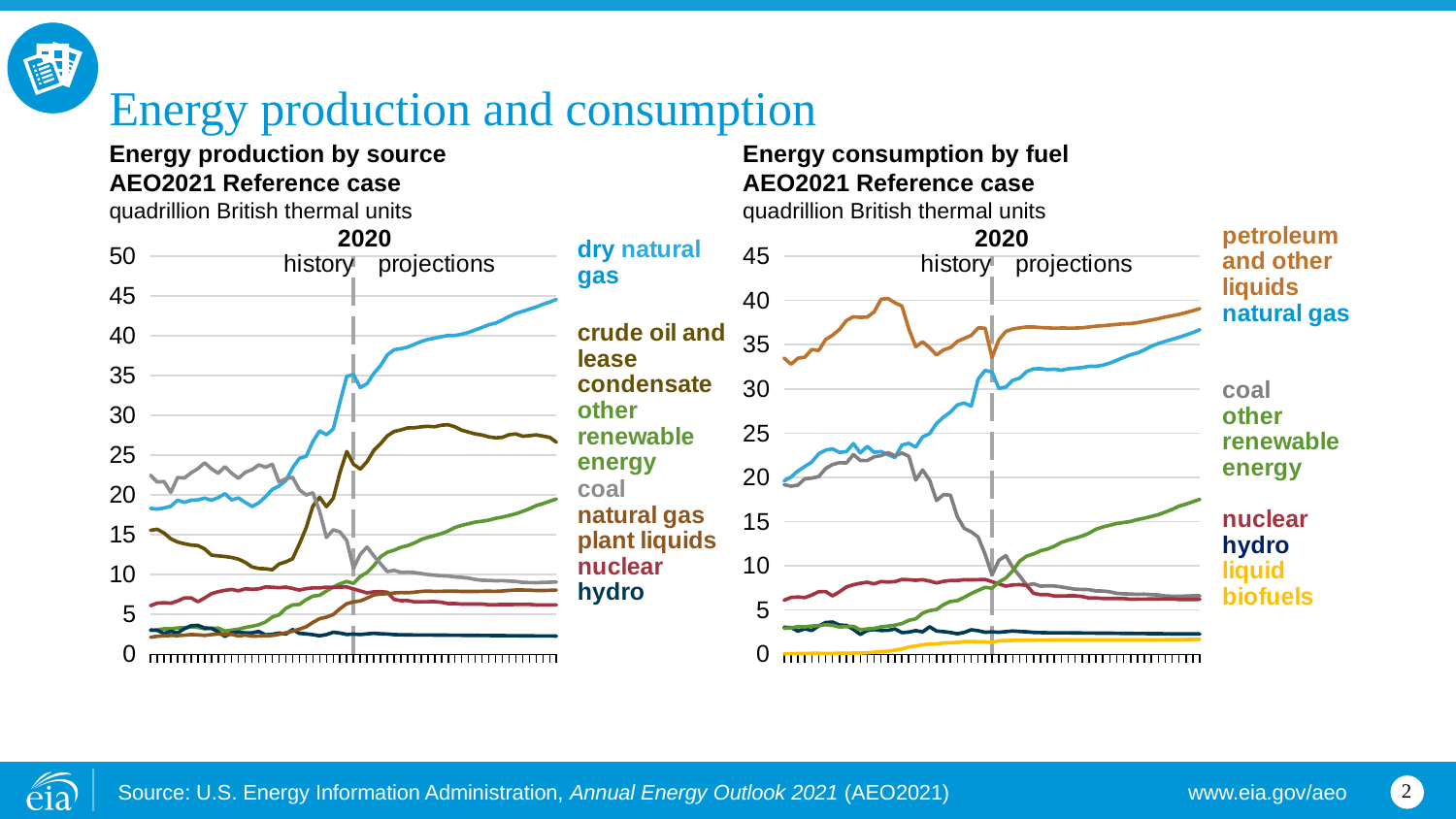
How many series are labelled on the 'Energy consumption by fuel' chart on the right? 7 In the 'Energy consumption by fuel' chart, does the coal line rise or fall over the projection period? fall In the 'Energy consumption by fuel' chart, is the value for natural gas at the end of the projection period greater or less than 35? greater In the 'Energy consumption by fuel' chart, is the value for other renewable energy at the end of the projection period greater or less than 15? greater In the 'Energy production by source' chart, is the value for coal at the end of the projection period greater or less than 10? less In the 'Energy production by source' chart, which is larger at the end of the projection period: dry natural gas or crude oil and lease condensate? dry natural gas In the 'Energy production by source' chart, which source has the highest value at the end of the projection period? dry natural gas In the 'Energy consumption by fuel' chart, which fuel has the highest value at the end of the projection period? petroleum and other liquids What unit is used on the y axis of both charts? quadrillion British thermal units What type of chart is the 'Energy production by source' chart on the left? line chart How many series are labelled on the 'Energy production by source' chart on the left? 7